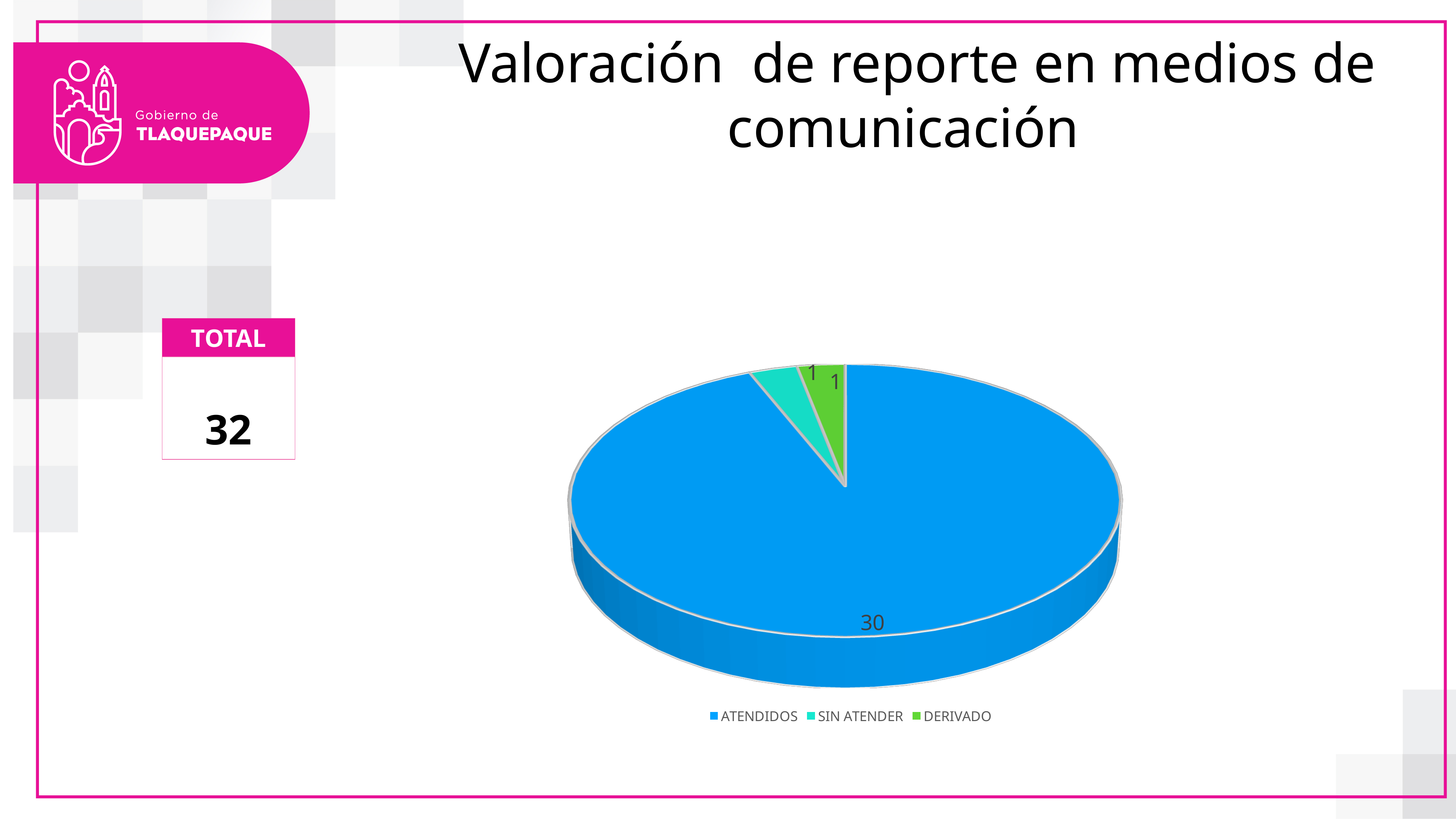
What colour is the ATENDIDOS slice? Blue How many categories does the legend list? 3 What is the title of the chart on the slide? Valoración de reporte en medios de comunicación What is the value for DERIVADO? 1 Which category has the largest slice of the pie? ATENDIDOS What kind of chart is shown on the slide? Pie chart Which is larger, the value for ATENDIDOS or the value for DERIVADO? ATENDIDOS What is the difference between the values for ATENDIDOS and SIN ATENDER? 29 What is the value for ATENDIDOS? 30 What is the value for SIN ATENDER? 1 What is the total of all slices in the pie chart? 32 How many slices does the pie chart have? 3